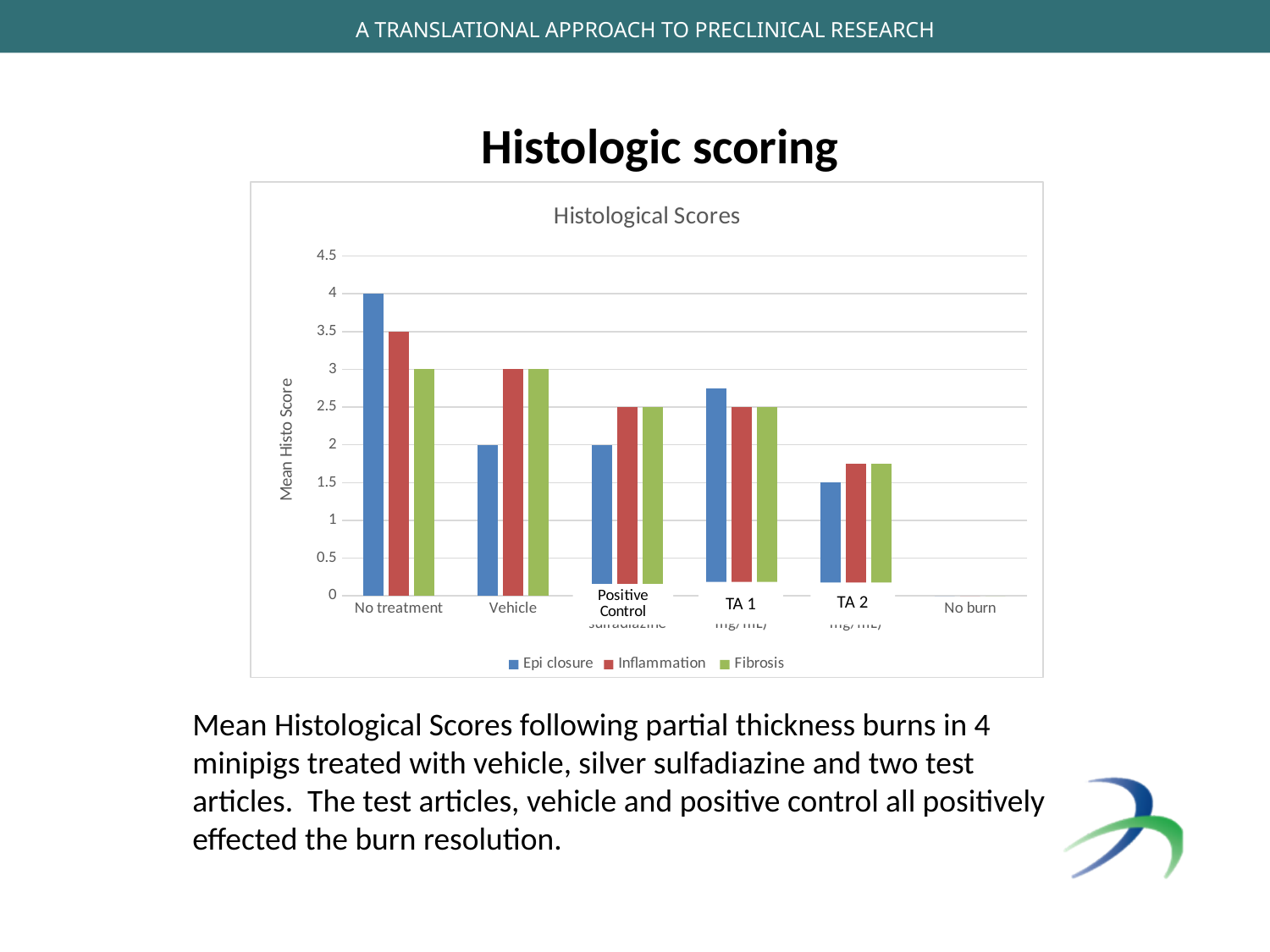
What is the Epi closure score for the TA 2 group? 1.5 What is the Epi closure score for the No treatment group? 4 Which group has the highest Epi closure score? No treatment What is the label on the y axis of the Histological Scores chart? Mean Histo Score What is the Fibrosis score for the Vehicle group? 3 What is the difference between the Epi closure score for No treatment and the Epi closure score for Vehicle? 2 How many series does the legend of the Histological Scores chart list? 3 What is the Inflammation score for the No treatment group? 3.5 What type of chart is shown on the slide? Bar chart Is the Epi closure value for TA 1 greater or less than 2.5? greater Which has the larger Inflammation score, Vehicle or Positive Control? Vehicle How many treatment groups are shown on the x axis of the Histological Scores chart? 6